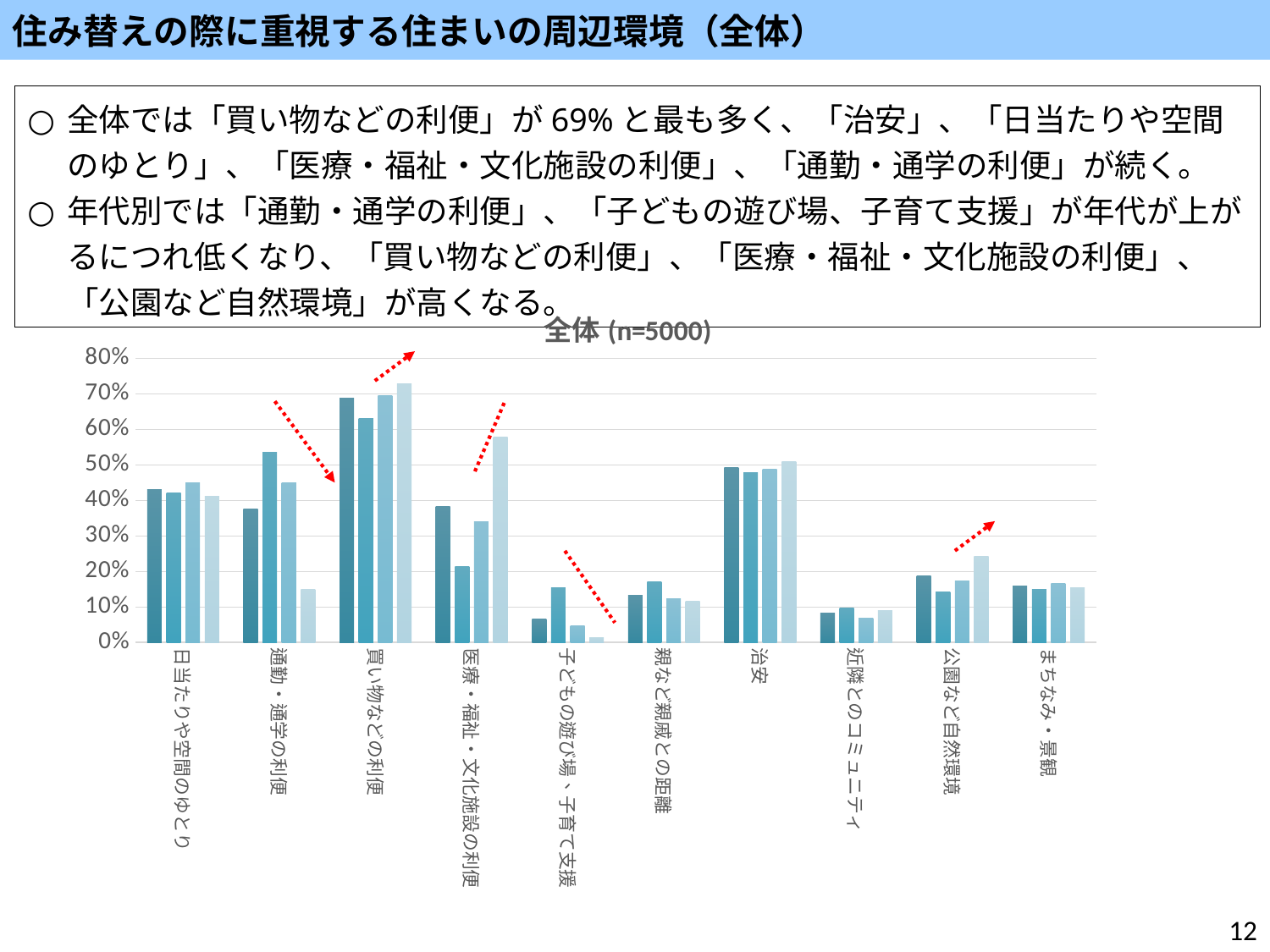
Are all the bars for 近隣とのコミュニティ greater or less than 20%? less Is the tallest bar for 買い物などの利便 greater or less than 70%? greater Are all the bars for 治安 greater or less than 40%? greater Which category has the tallest bar in the chart? 買い物などの利便 What is the title of the chart? 全体 (n=5000) Which category has higher bars overall, 治安 or 親など親戚との距離? 治安 How many bars are plotted for each category in the chart? 4 How many categories are shown on the x axis of the chart? 10 What kind of chart is shown on the slide? bar chart What is the highest value shown on the y axis of the chart? 80% Which category has higher bars overall, 買い物などの利便 or まちなみ・景観? 買い物などの利便